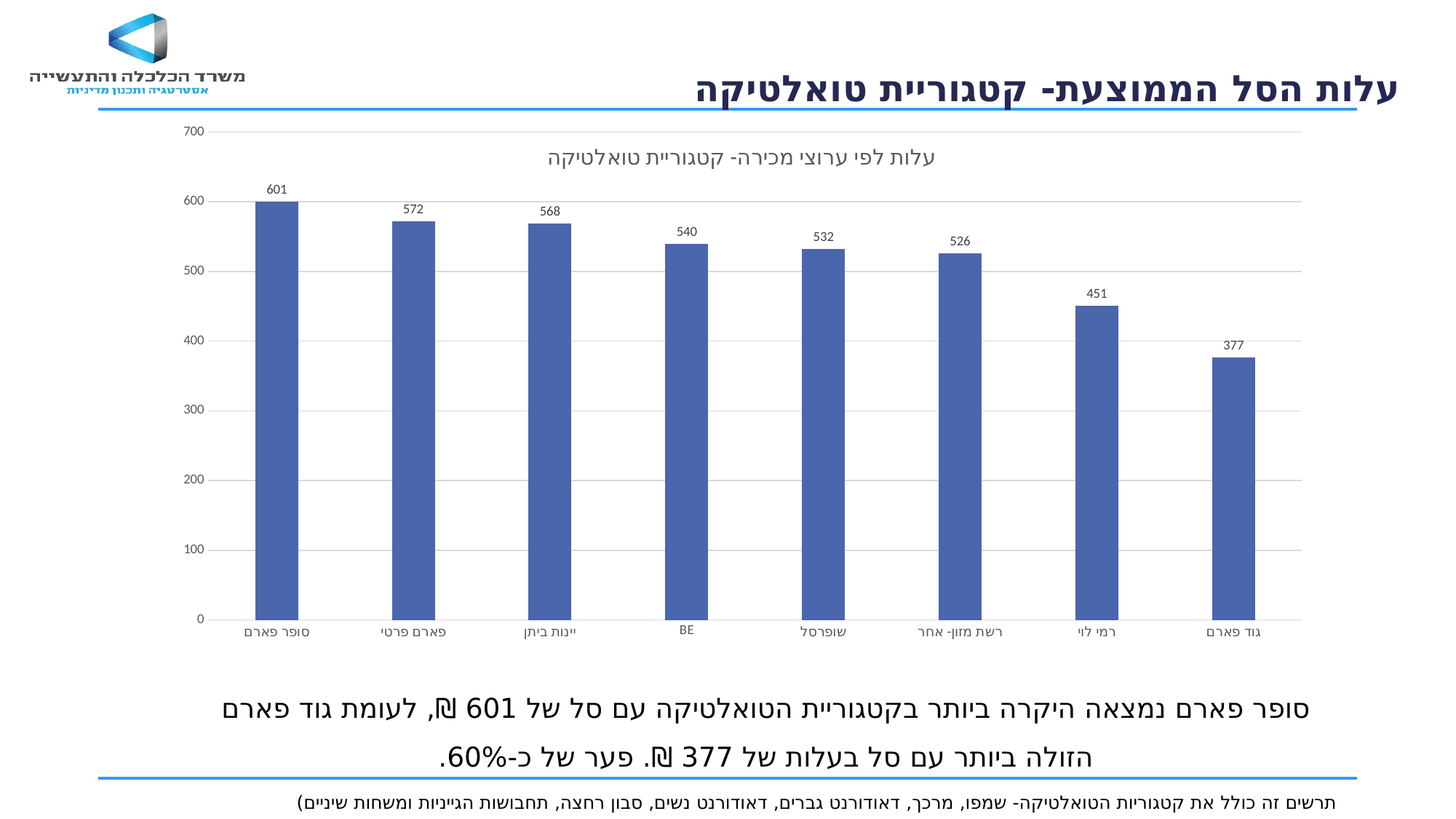
What kind of chart is shown on the slide? Bar chart What is the value for רמי לוי? 451 What is the value for שופרסל? 532 Which is larger, the value for רשת מזון- אחר or the value for רמי לוי? רשת מזון- אחר What is the difference between the values for פארם פרטי and יינות ביתן? 4 What is the title of the chart? עלות לפי ערוצי מכירה- קטגוריית טואלטיקה What is the value for BE? 540 Which category has the lowest value? גוד פארם How many categories are shown on the chart? 8 What is the value for סופר פארם? 601 What is the difference between the values for סופר פארם and גוד פארם? 224 Which category has the highest value? סופר פארם